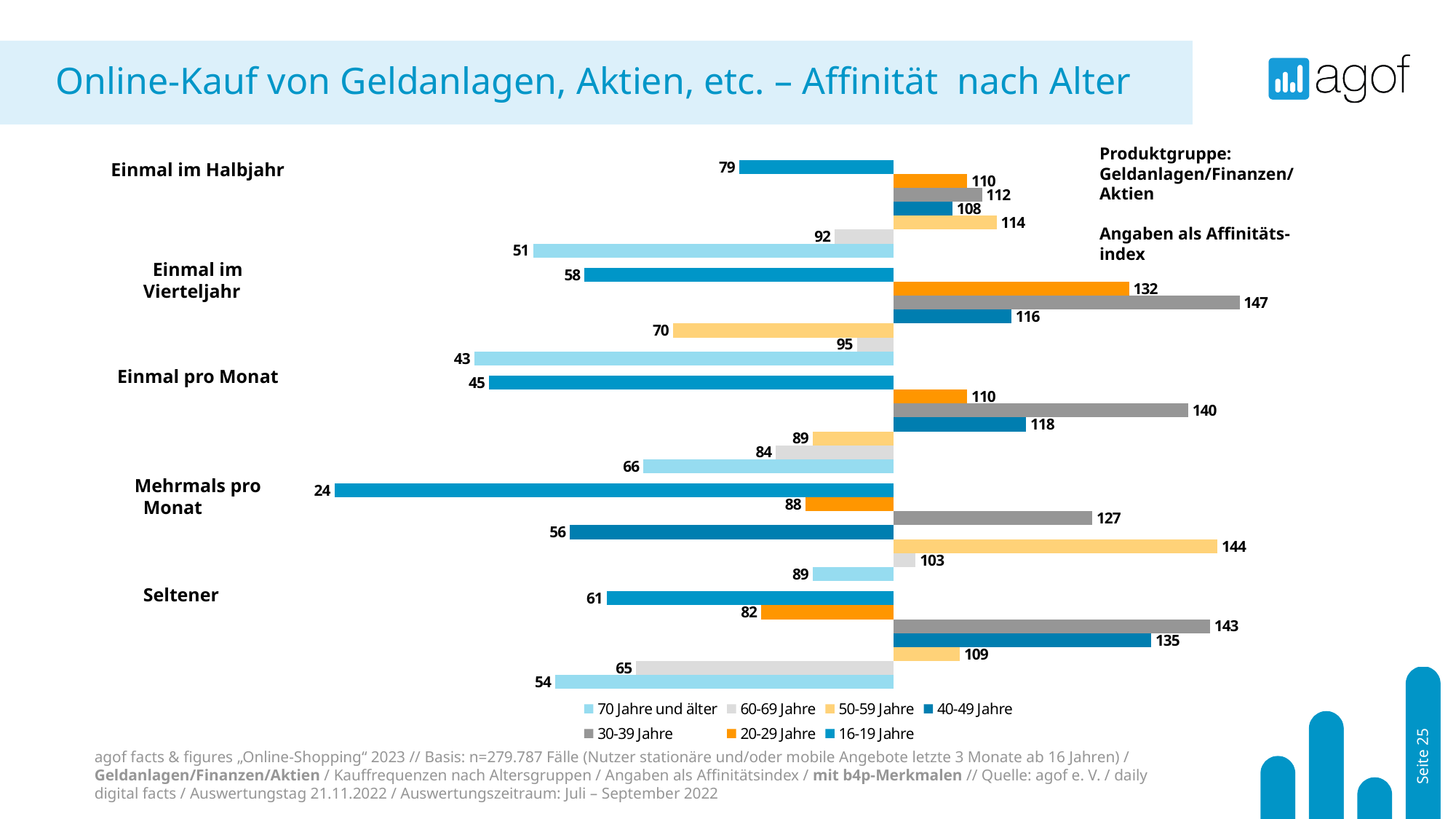
What is the difference between the 30-39 Jahre and 40-49 Jahre affinity indices for 'Seltener'? 8 How many purchase-frequency categories are shown on the chart? 5 What is the affinity index for the 16-19 Jahre group for 'Mehrmals pro Monat'? 24 What is the affinity index for the 70 Jahre und älter group for 'Seltener'? 54 What type of chart is shown on the slide? Bar chart How many age groups does the legend list? 7 For 'Einmal im Vierteljahr', which is larger: the value for 20-29 Jahre or for 40-49 Jahre? 20-29 Jahre What is the affinity index for the 30-39 Jahre group for 'Einmal im Vierteljahr'? 147 What is the affinity index for the 50-59 Jahre group for 'Mehrmals pro Monat'? 144 Which age group has the lowest affinity index for 'Einmal im Halbjahr'? 70 Jahre und älter Which age group has the highest affinity index for 'Einmal pro Monat'? 30-39 Jahre Which product group does the chart refer to, according to the note on the right? Geldanlagen/Finanzen/Aktien